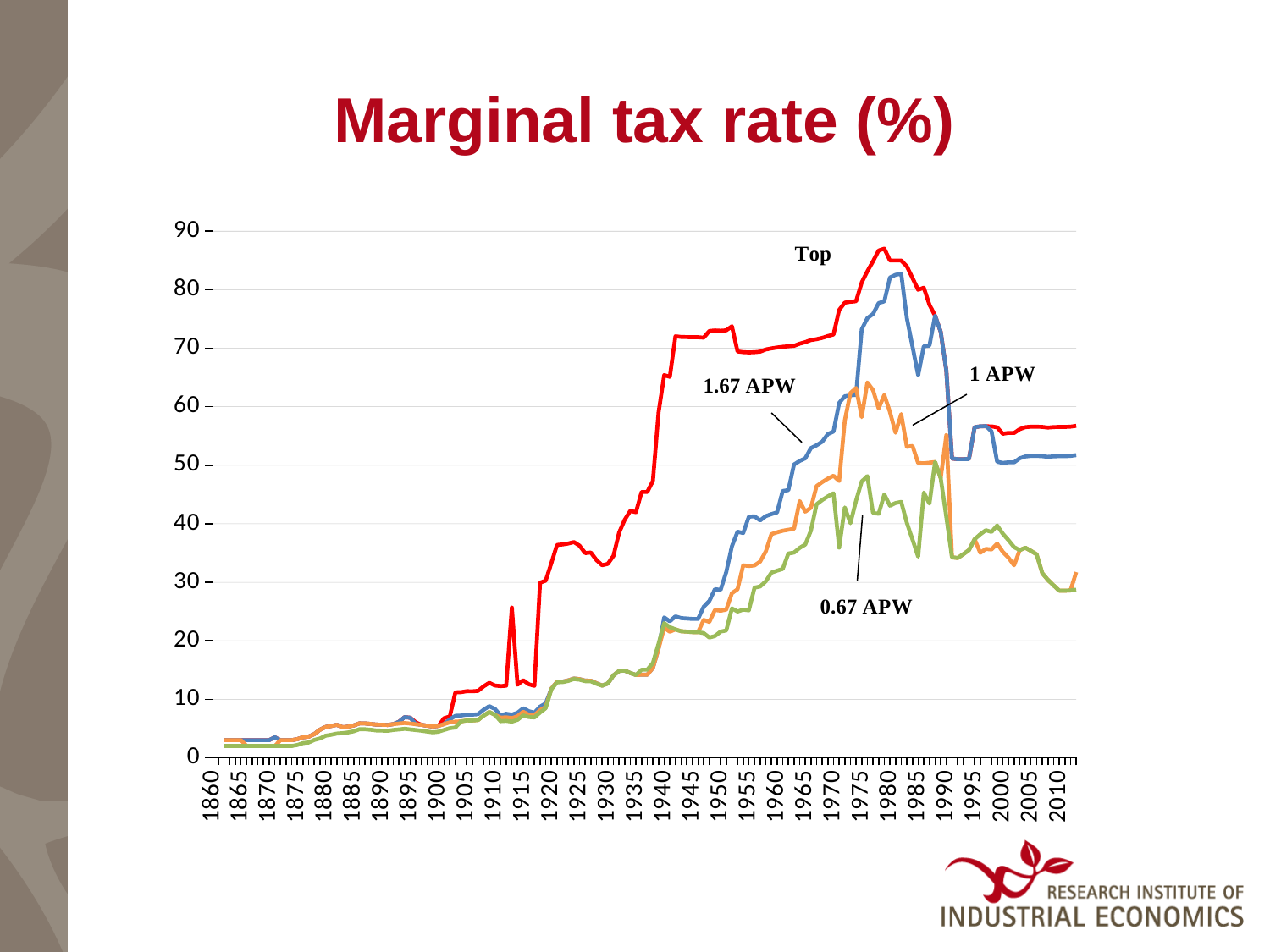
Which series reaches the highest marginal tax rate on the chart? Top How many series are plotted on the chart? 4 Is the value for the Top series around 1925 greater or less than 40? less Does the Top series generally rise or fall between 1860 and 1980? rise Around 2000, which is larger: the Top series or the 0.67 APW series? Top Is the value for the Top series around 2010 greater or less than 50? greater What kind of chart is shown on the slide? line chart Is the value for the 0.67 APW series around 2010 greater or less than 40? less What is the title of the chart? Marginal tax rate (%) Which series has the lowest value around 1985? 0.67 APW